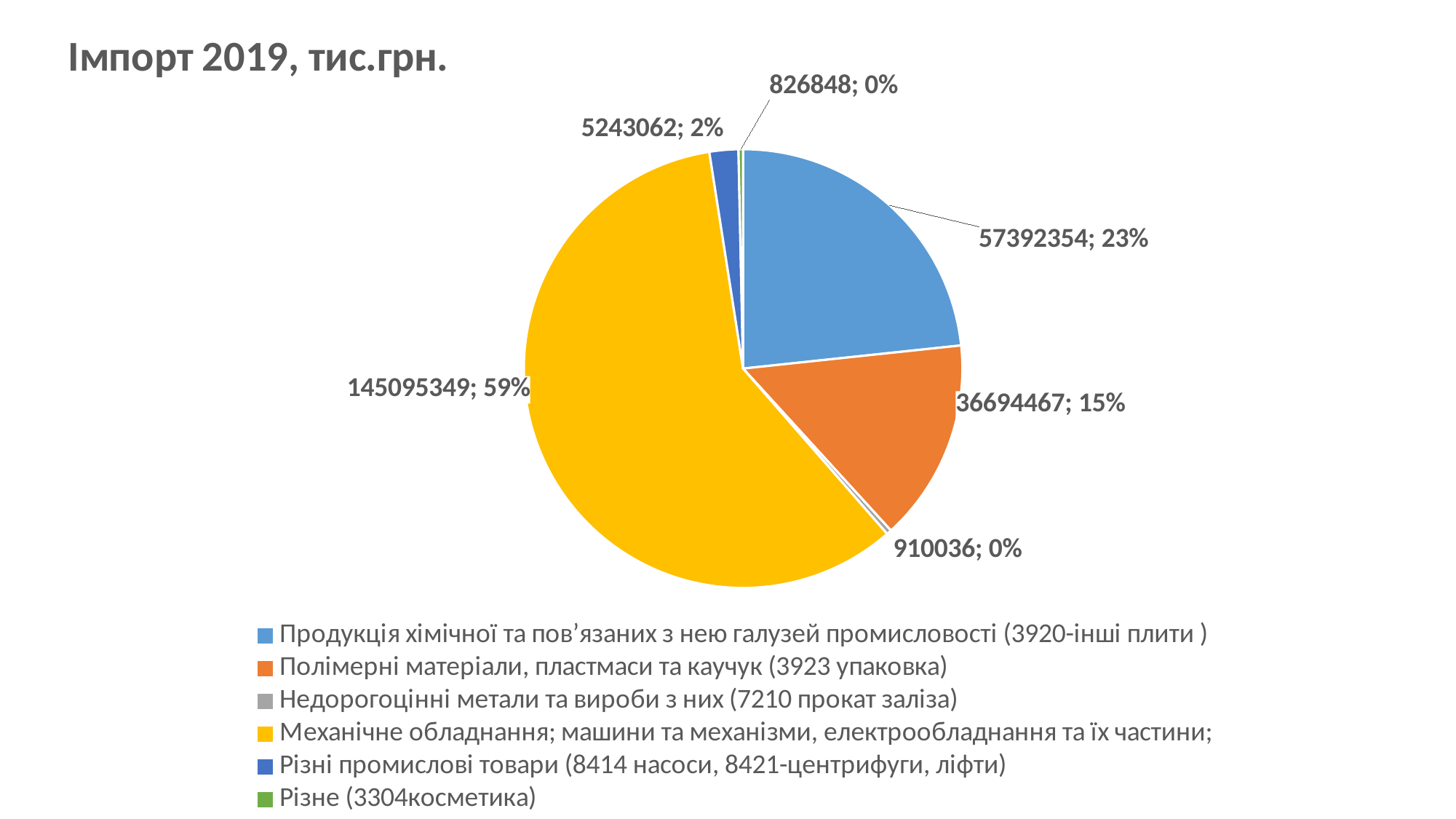
How many slices does the pie chart have? 6 What share of the pie does Різні промислові товари (8414 насоси, 8421-центрифуги, ліфти) have? 2% What is the title of the chart? Імпорт 2019, тис.грн. Which category has the smallest value? Різне (3304косметика) What kind of chart is shown on the slide? pie chart What share of the pie does Продукція хімічної та пов’язаних з нею галузей промисловості (3920-інші плити) have? 23% What is the value for Полімерні матеріали, пластмаси та каучук (3923 упаковка)? 36694467 What is the value for Механічне обладнання; машини та механізми, електрообладнання та їх частини? 145095349 What colour is the slice for Полімерні матеріали, пластмаси та каучук (3923 упаковка)? orange Which is larger: the value for Недорогоцінні метали та вироби з них (7210 прокат заліза) or the value for Різне (3304косметика)? Недорогоцінні метали та вироби з них (7210 прокат заліза) What is the difference between the values for Механічне обладнання and Продукція хімічної та пов’язаних з нею галузей промисловості? 87702995 Which category has the largest slice? Механічне обладнання; машини та механізми, електрообладнання та їх частини